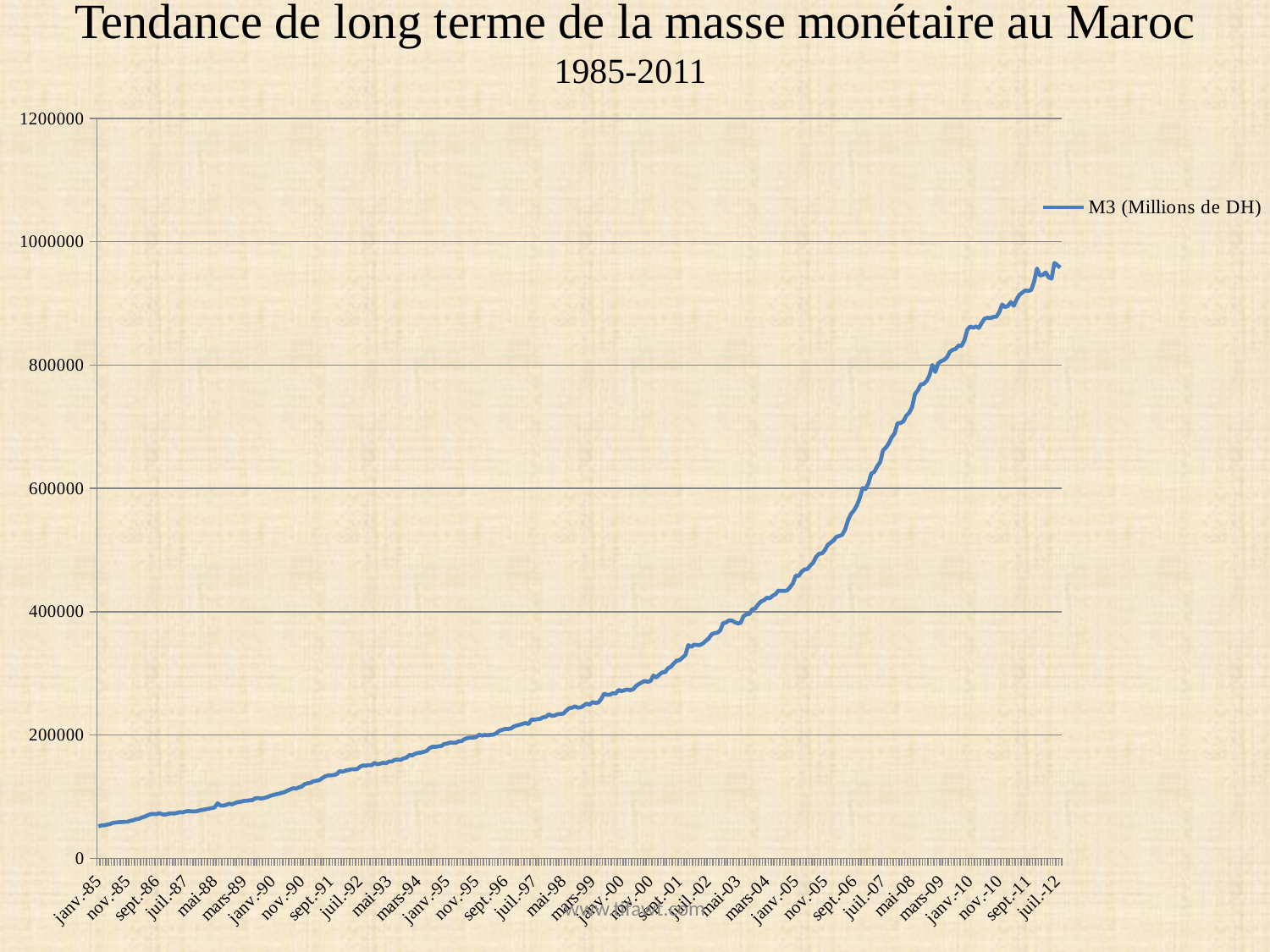
Is the value of M3 at janv.-85 greater or less than 200000? less How many series does the legend list? 1 At which end of the period, the start (janv.-85) or the end (juil.-12), is the value of M3 lowest? janv.-85 What kind of chart is shown on the slide? line chart Is the value of M3 at juil.-12 greater or less than 800000? greater Is the value of M3 at janv.-00 greater or less than 400000? less What is the title of the chart? Tendance de long terme de la masse monétaire au Maroc 1985-2011 What is the name of the series shown in the legend? M3 (Millions de DH) Which is larger, the value of M3 at janv.-95 or at janv.-05? janv.-05 Do the values of M3 generally rise or fall from janv.-85 to juil.-12? rise